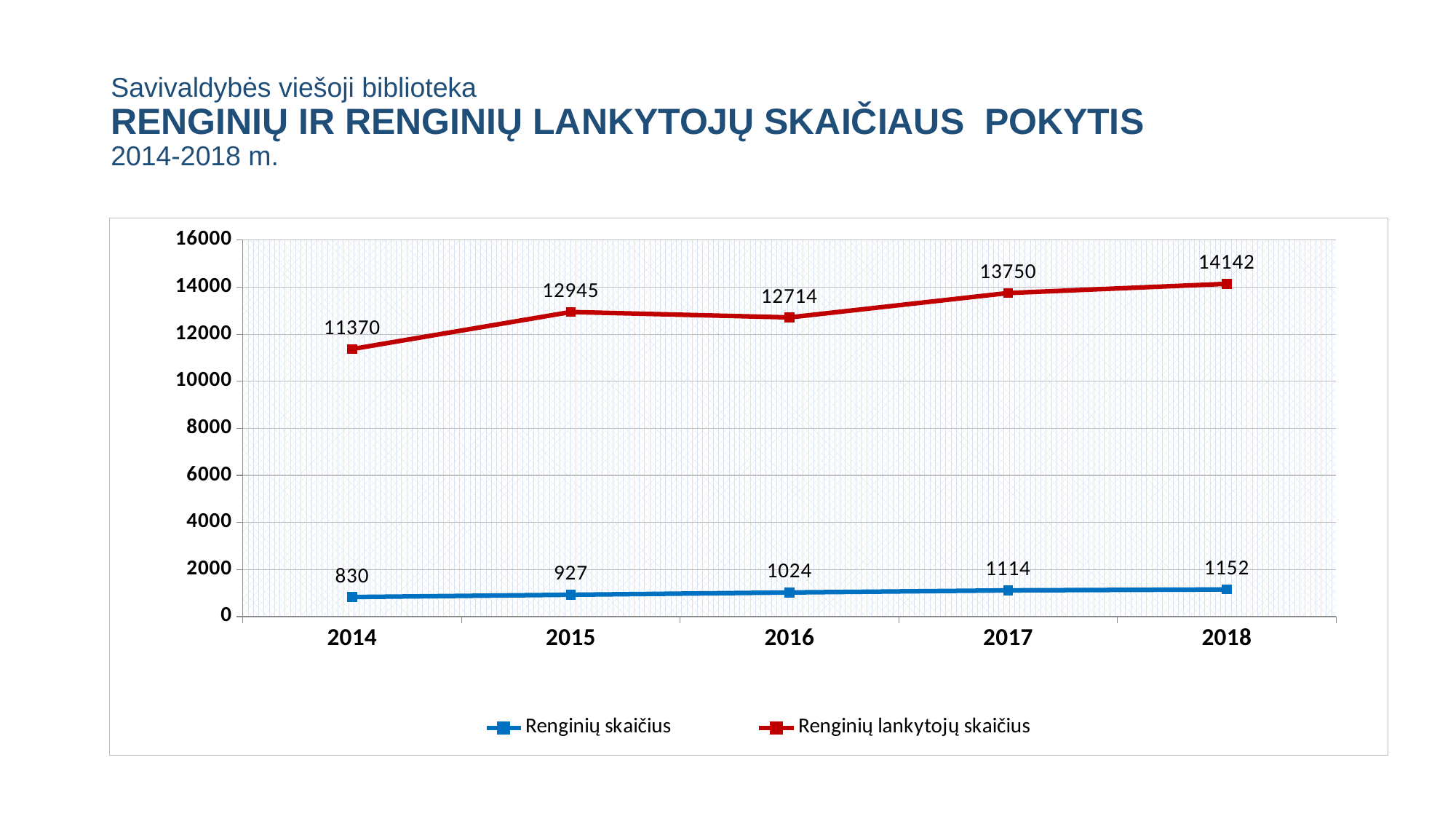
In which year is Renginių skaičius lowest? 2014 In which year is Renginių lankytojų skaičius highest? 2018 What kind of chart is shown on the slide? line chart What is the value of Renginių lankytojų skaičius in 2017? 13750 What is the difference between Renginių skaičius in 2015 and in 2014? 97 How many years are shown on the x axis? 5 How many series does the legend list? 2 What is the value of Renginių skaičius in 2016? 1024 What is the value of Renginių lankytojų skaičius in 2014? 11370 What is the difference between Renginių lankytojų skaičius in 2018 and in 2014? 2772 Which is larger: Renginių lankytojų skaičius in 2015 or in 2016? 2015 Is the value of Renginių lankytojų skaičius in 2017 greater or less than 12000? greater